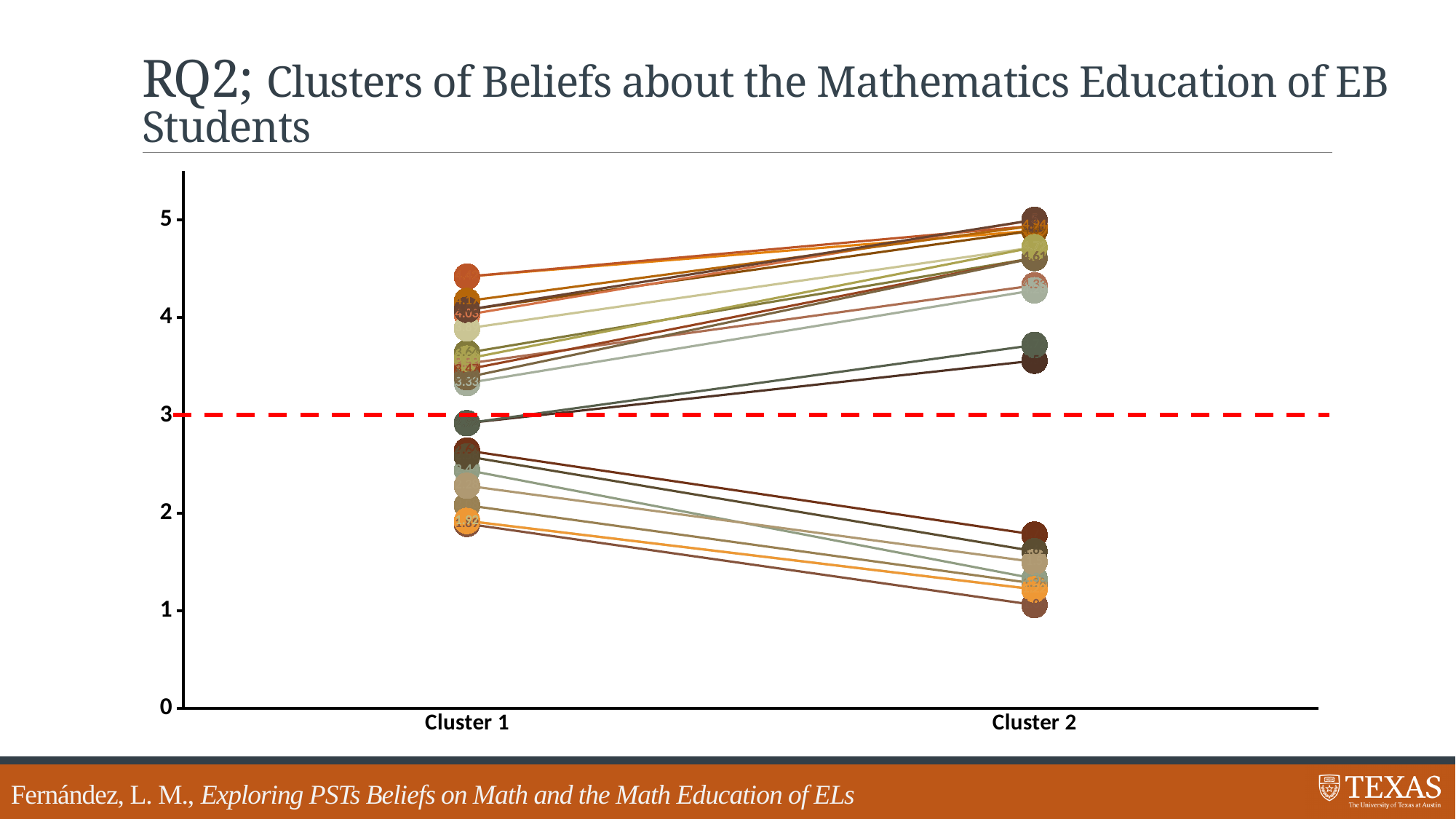
What are the two categories on the x axis? Cluster 1 and Cluster 2 At what value on the y axis is the dashed red horizontal line drawn? 3 Is the lowest value plotted at Cluster 1 greater or less than 2? less Is the highest value plotted at Cluster 1 greater or less than 4? greater Do the series that start above the dashed line at Cluster 1 rise or fall from Cluster 1 to Cluster 2? rise How many categories are shown on the x axis? 2 Is the highest value plotted at Cluster 2 greater or less than 4? greater Which cluster has the higher maximum plotted value, Cluster 1 or Cluster 2? Cluster 2 What kind of chart is shown on the slide? line chart Which cluster has the lower minimum plotted value, Cluster 1 or Cluster 2? Cluster 2